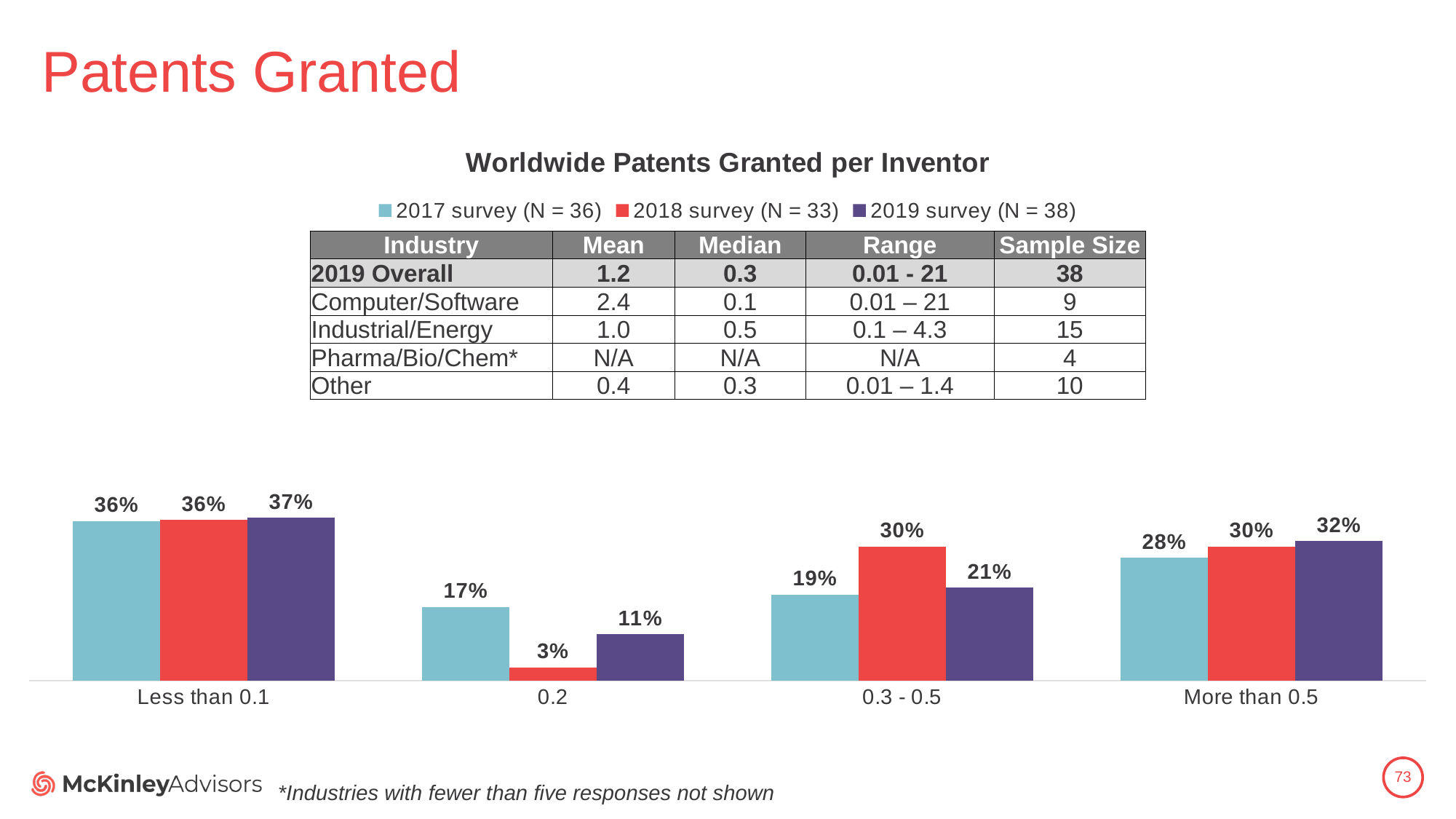
Which category has the lowest value for the 2019 survey? 0.2 What kind of chart is shown on the slide? Bar chart What is the title of the chart? Worldwide Patents Granted per Inventor How many categories are shown on the x axis of the chart? 4 Which category has the highest value for the 2018 survey? Less than 0.1 What is the value for the 2018 survey in the '0.2' category? 3% What is the value for the 2017 survey in the 'More than 0.5' category? 28% What is the value for the 2019 survey in the 'Less than 0.1' category? 37% Which is larger in the '0.2' category: the 2017 survey value or the 2019 survey value? 2017 survey How many series does the chart legend list? 3 What is the difference between the 2018 survey and 2019 survey values in the '0.3 - 0.5' category? 9% What is the sample size (N) for the 2019 survey shown in the legend? 38